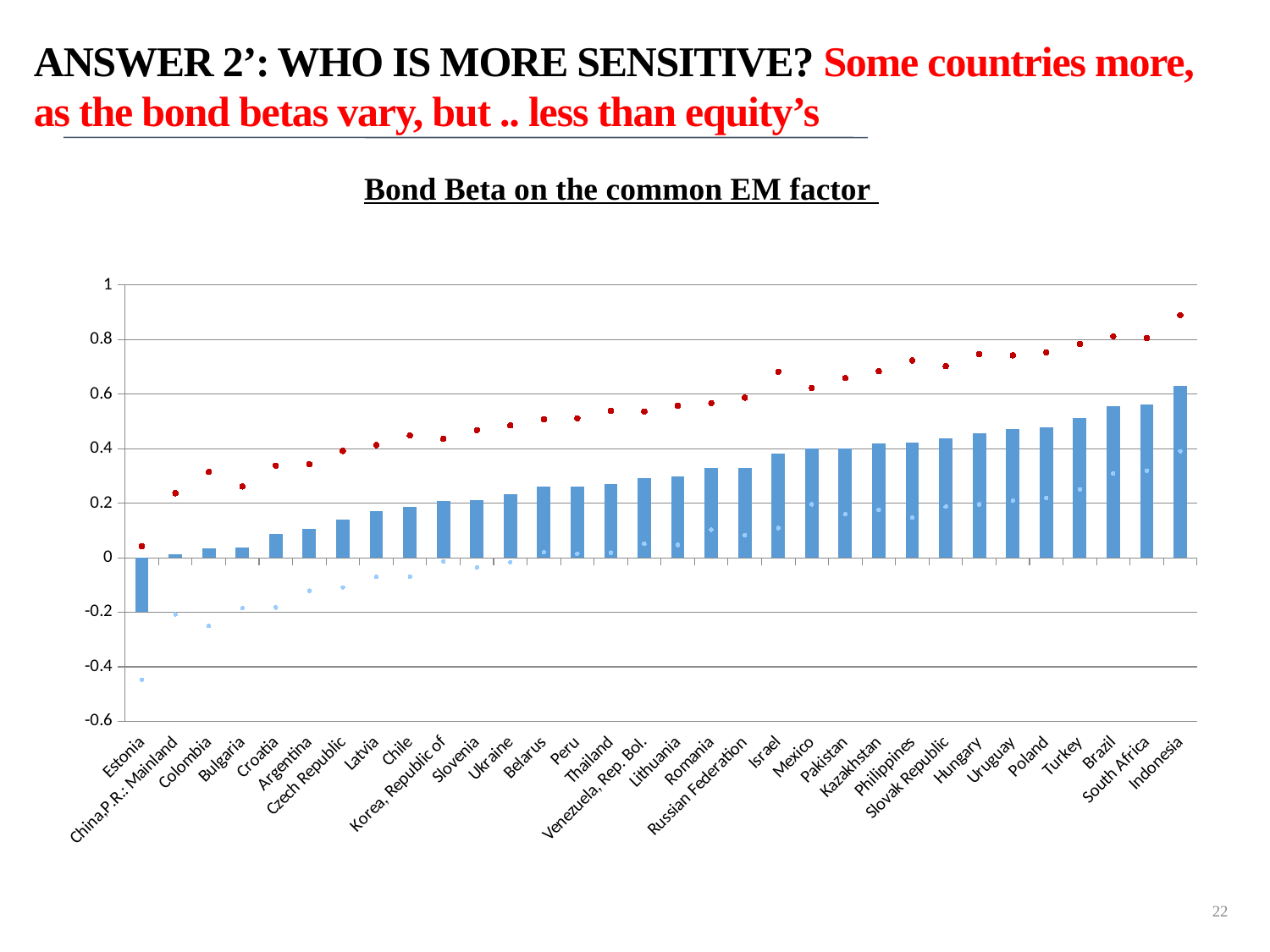
What kind of chart is shown on the slide? bar chart Which country has the lowest bond beta bar? Estonia Which country has the highest bond beta bar? Indonesia Do the bar values rise or fall moving from left to right along the x axis? rise What is the title of the chart? Bond Beta on the common EM factor Is the bar value for Mexico greater or less than 0.2? greater Is the bar value for Estonia greater or less than 0? less Which has the larger bar value, Brazil or Chile? Brazil Is the bar value for Czech Republic greater or less than 0.2? less Which has the larger bar value, Israel or Latvia? Israel How many countries are shown on the x axis of the chart? 32